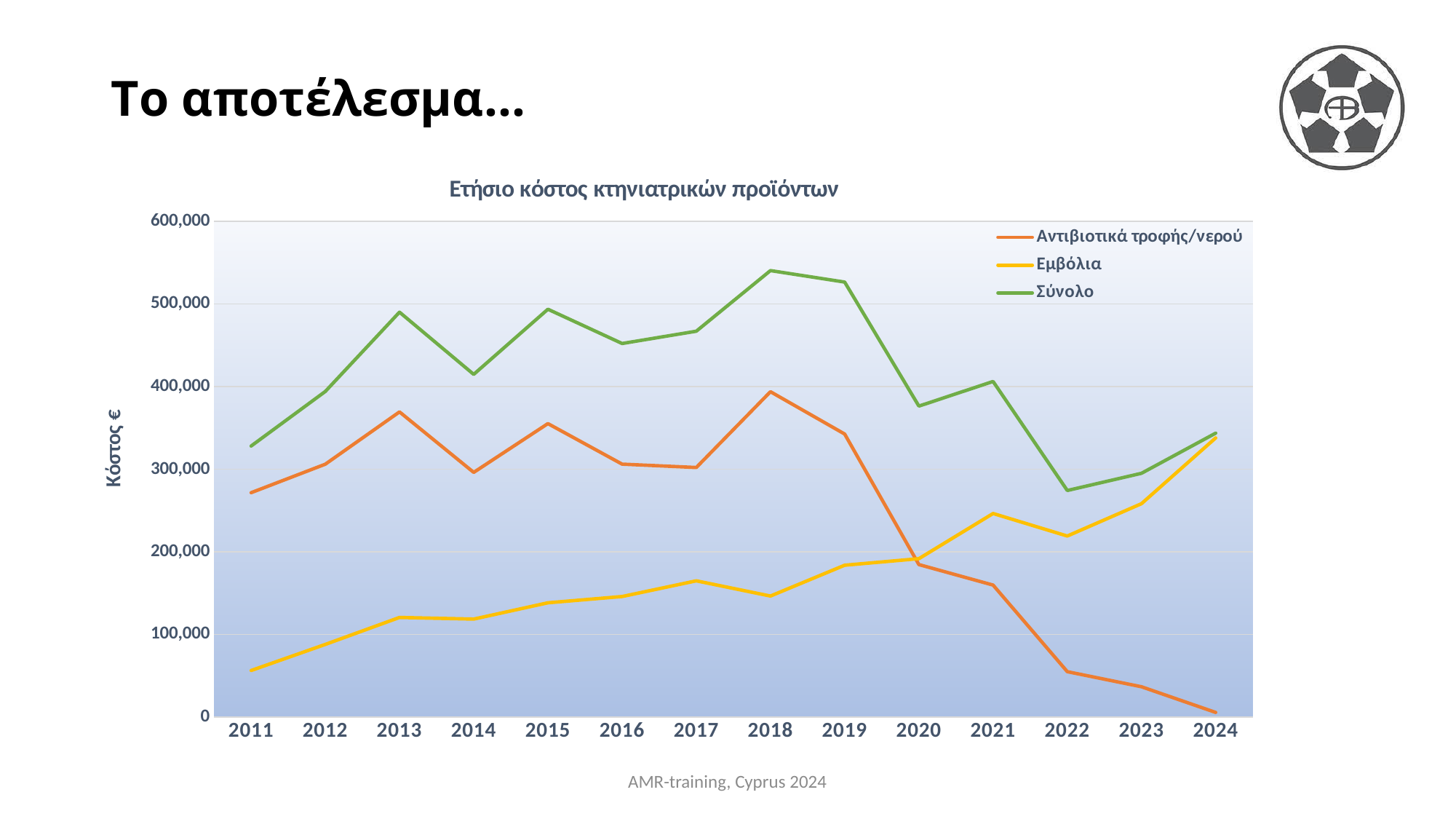
In which year is the Αντιβιοτικά τροφής/νερού series at its lowest? 2024 Does the Εμβόλια series generally rise or fall from 2011 to 2024? rise In which year does the Εμβόλια series reach its highest value? 2024 Is the Σύνολο value for 2018 greater or less than 500,000? greater What kind of chart is shown on the slide? line chart How many series does the legend list? 3 What is the title of the chart? Ετήσιο κόστος κτηνιατρικών προϊόντων In which year does the Σύνολο series reach its highest value? 2018 In which year is the Σύνολο series at its lowest? 2022 Is the Αντιβιοτικά τροφής/νερού value for 2022 greater or less than 100,000? less In 2021, which series has the larger value: Αντιβιοτικά τροφής/νερού or Εμβόλια? Εμβόλια How many years are plotted along the x axis? 14